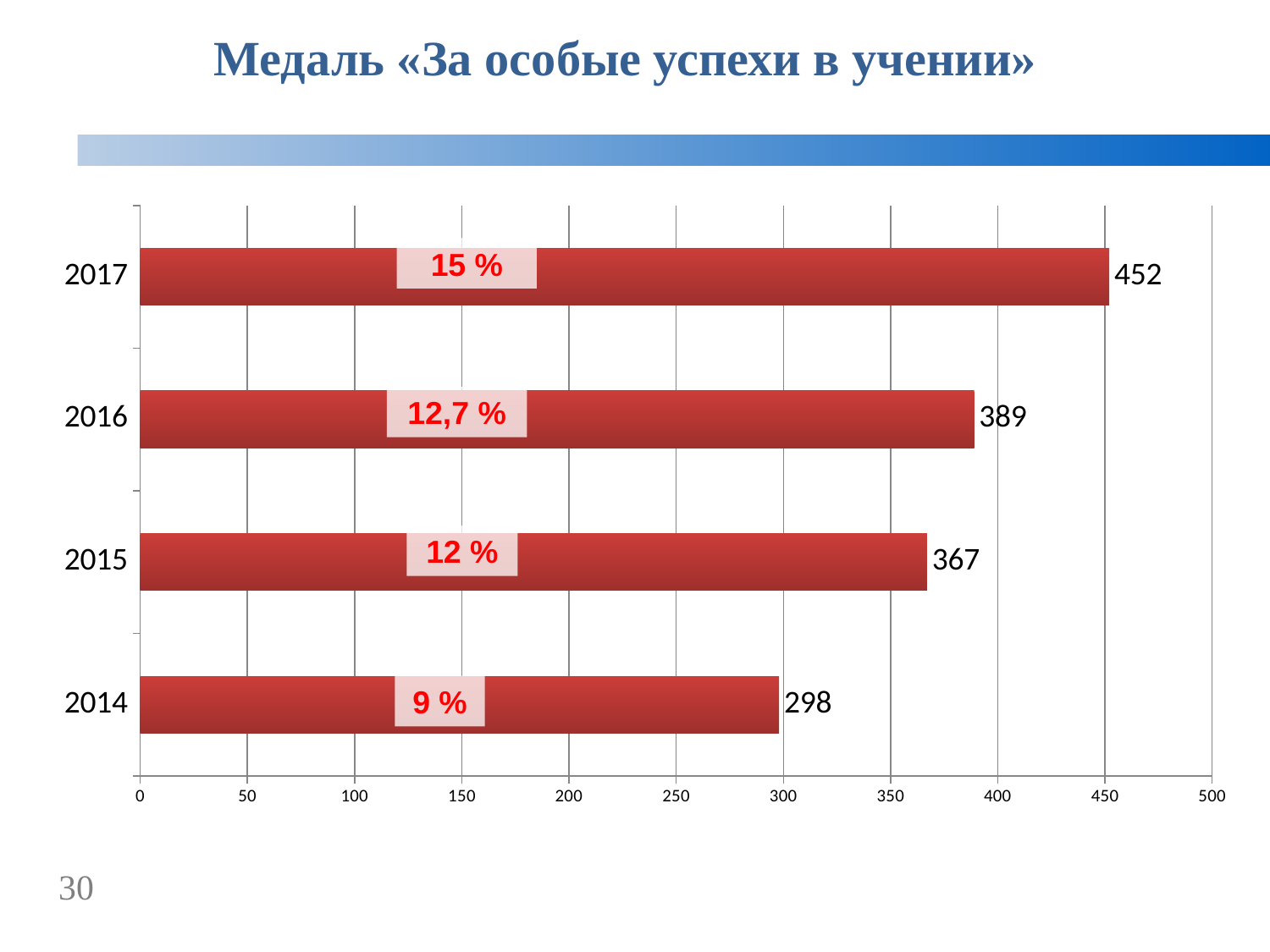
What is the difference between the values for 2017 and 2016? 63 Which is larger, the value for 2016 or the value for 2015? 2016 What is the difference between the values for 2015 and 2014? 69 Is the value for 2015 greater or less than 350? greater What percentage label is shown on the bar for 2016? 12,7 % What is the title of the slide? Медаль «За особые успехи в учении» Which year has the highest value? 2017 What is the value for 2017? 452 What is the value for 2014? 298 How many years are shown in the chart? 4 What kind of chart is shown on the slide? bar chart Which year has the lowest value? 2014